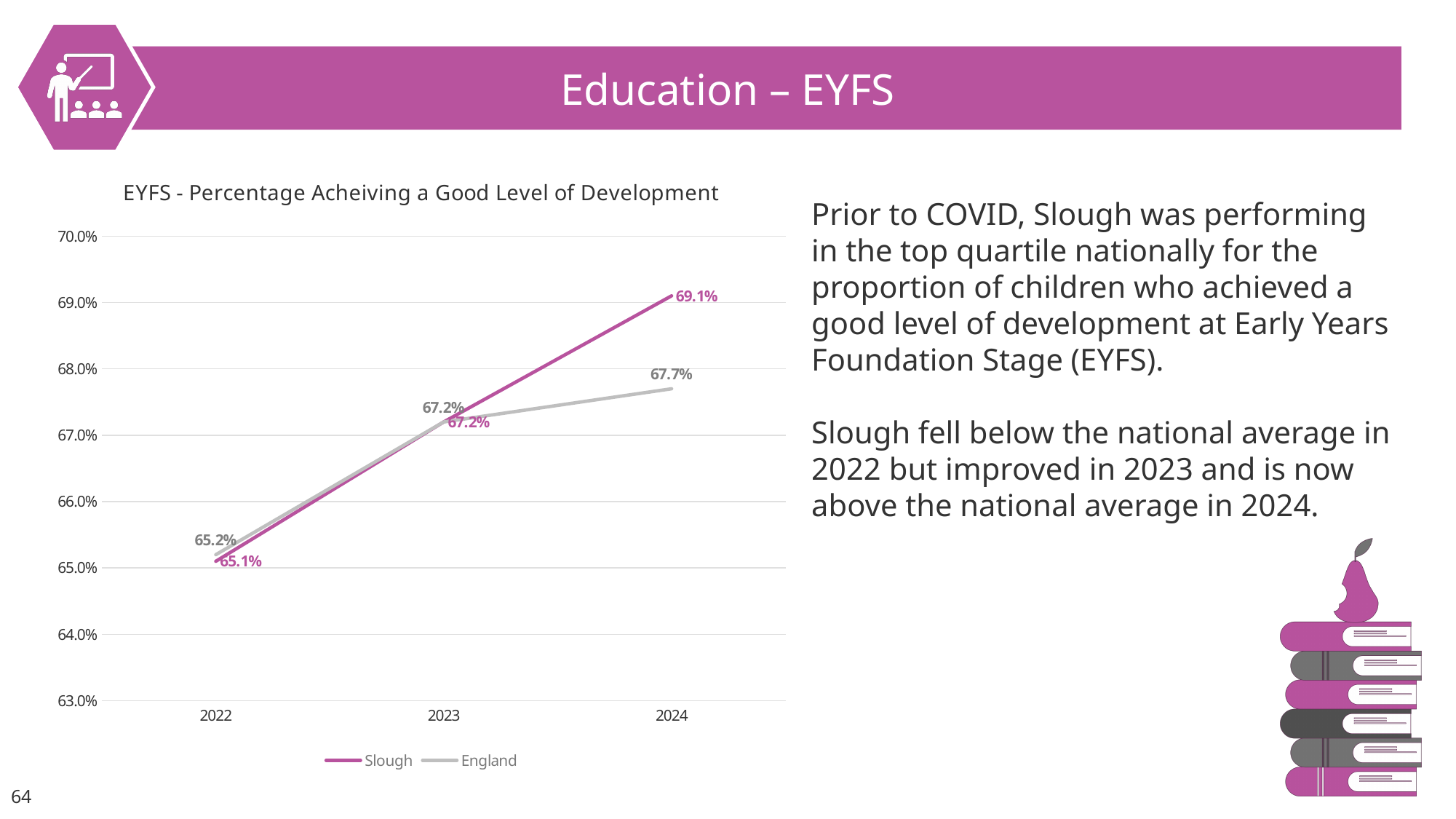
What kind of chart is shown on the slide? Line chart What is the value for England in 2024? 67.7% In which year is the England value lowest? 2022 How many series does the legend list? 2 What is the value for Slough in 2023? 67.2% What is the value for Slough in 2022? 65.1% What is the value for Slough in 2024? 69.1% What is the value for England in 2022? 65.2% What is the difference between the Slough and England values in 2024? 1.4% Which is larger in 2024, the Slough value or the England value? Slough In which year is the Slough value highest? 2024 How many years are shown on the x axis? 3